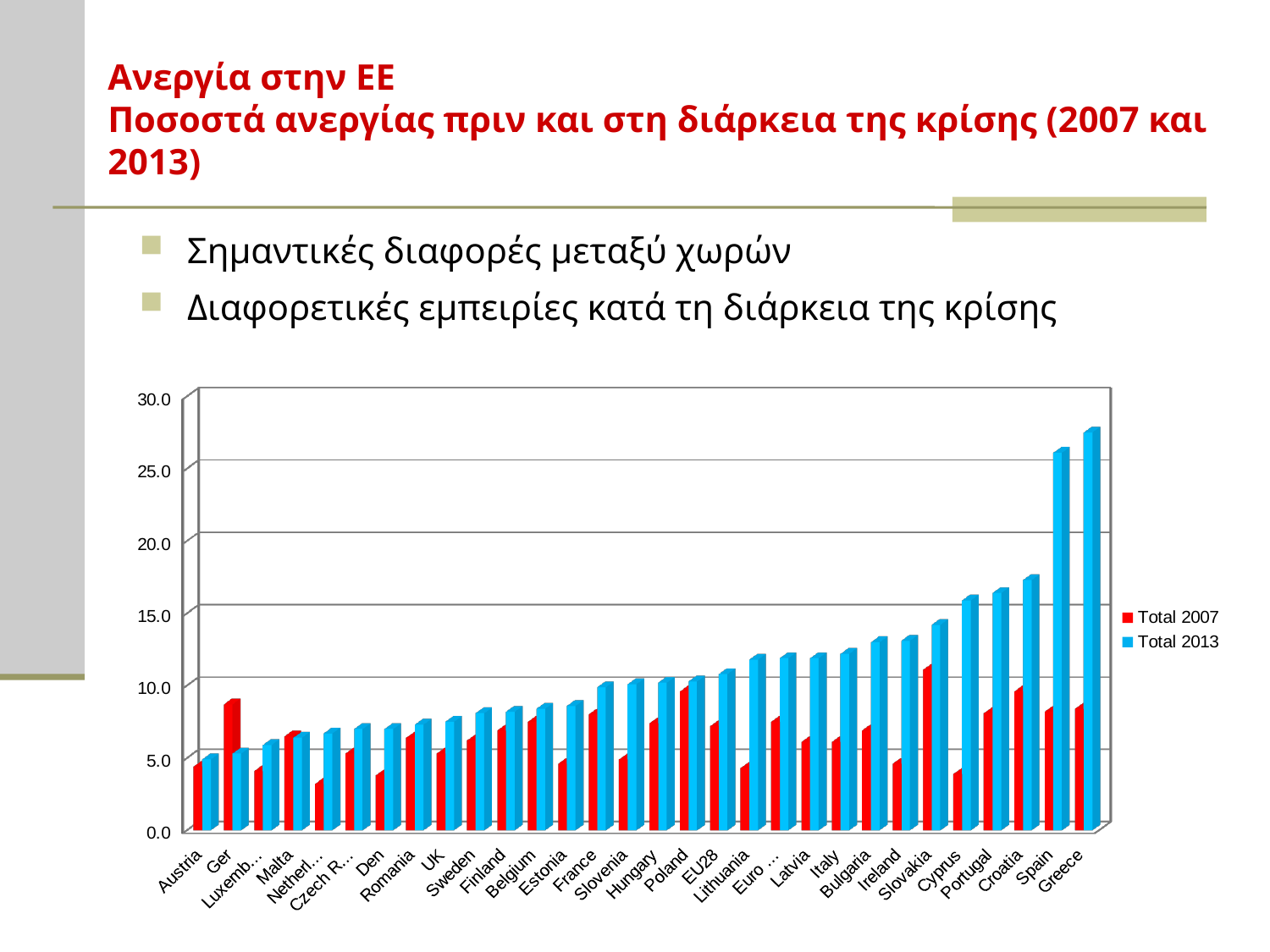
Which category has the highest Total 2007 value? Slovakia Is the Total 2013 value for Spain greater or less than 25.0? greater Do the Total 2013 values generally rise or fall moving from left to right along the x axis? rise Which category has the highest Total 2013 value? Greece What are the two series named in the legend? Total 2007 and Total 2013 Is the Total 2013 value for Croatia greater or less than 15.0? greater What kind of chart is shown on the slide? bar chart How many countries/categories are shown on the x axis? 30 For Ger, which is larger: the Total 2007 value or the Total 2013 value? Total 2007 Is the Total 2007 value for Slovakia greater or less than 10.0? greater How many series does the legend list? 2